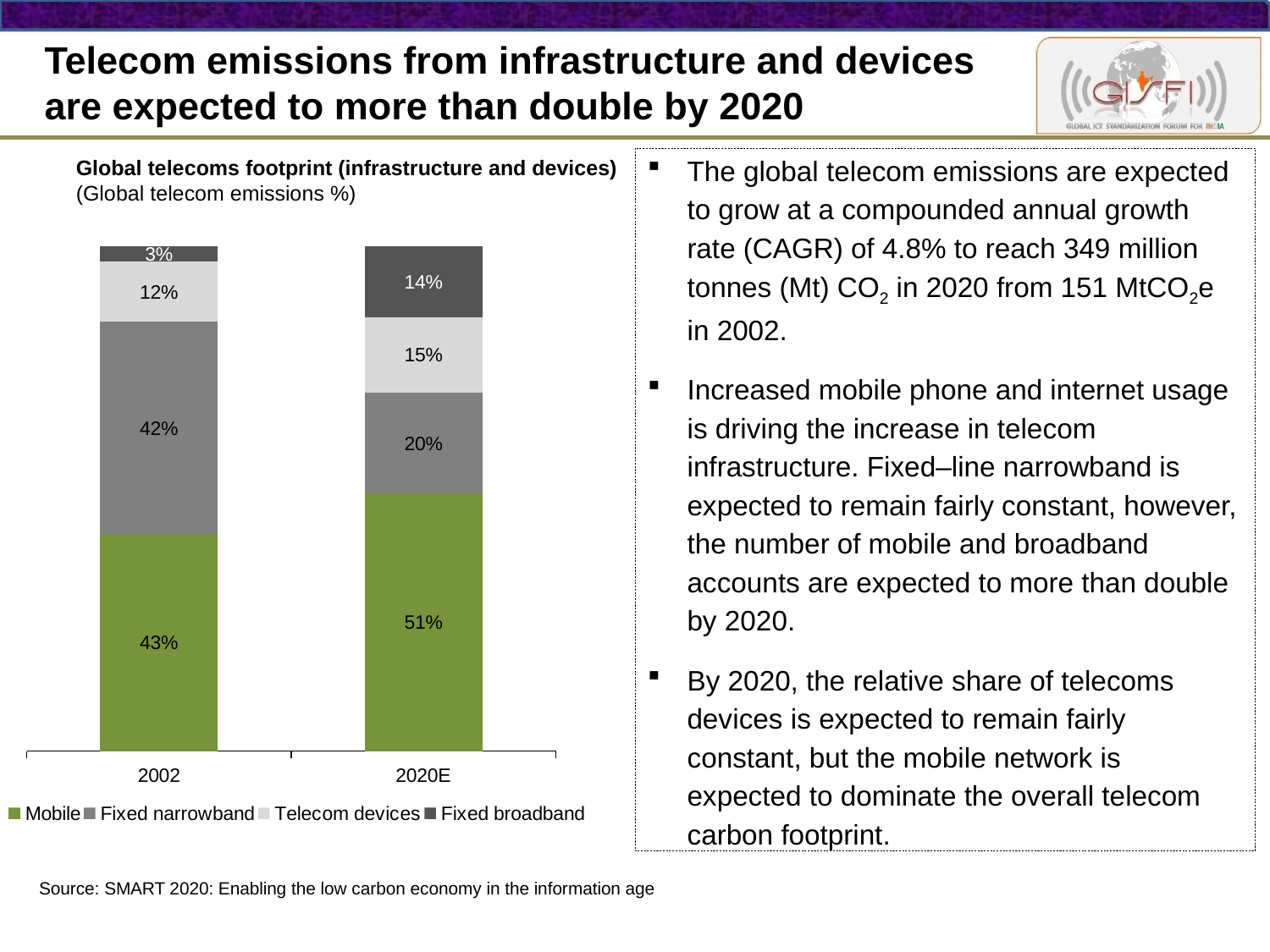
Which series has the smallest share in 2002? Fixed broadband What is the Fixed broadband share of global telecom emissions in 2002? 3% What is the Fixed narrowband share of global telecom emissions in 2020E? 20% What kind of chart is shown on the slide? Stacked bar chart Which series has the largest share in 2020E? Mobile By how many percentage points does the Mobile share in 2020E exceed the Mobile share in 2002? 8 Which is larger: the Fixed narrowband share in 2002 or the Fixed narrowband share in 2020E? 2002 How many categories are shown on the x axis? 2 How many series does the legend list? 4 What is the total of the stacked bar for 2002? 100% What is the Telecom devices share of global telecom emissions in 2020E? 15% What is the Mobile share of global telecom emissions in 2002? 43%